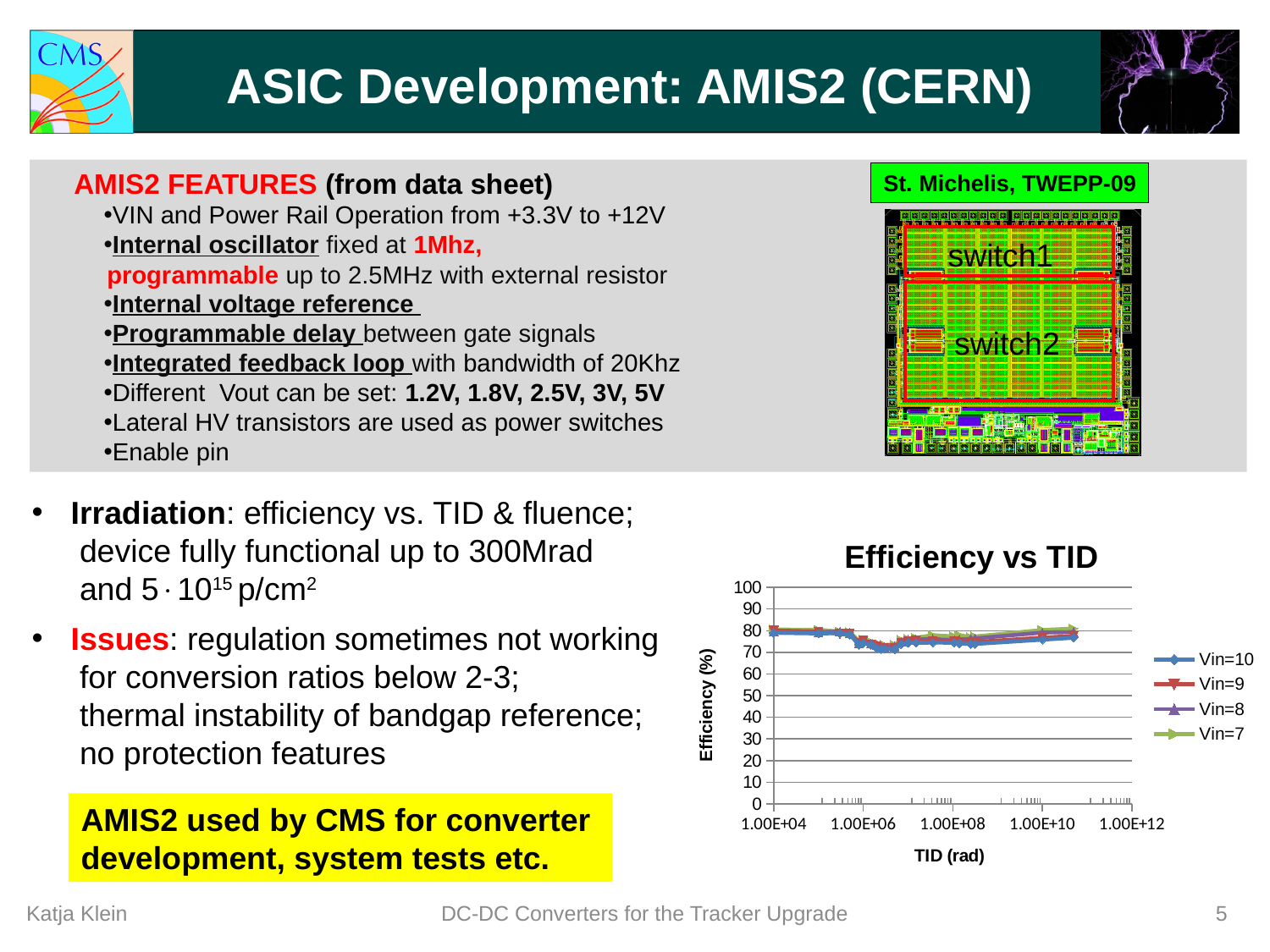
What is the title of the chart on the slide? Efficiency vs TID What is the label of the y axis of the Efficiency vs TID chart? Efficiency (%) In the Efficiency vs TID chart, is the efficiency for Vin=8 at the highest TID greater or less than 40? greater In the Efficiency vs TID chart, is the efficiency for Vin=10 at the lowest TID greater or less than 50? greater What is the maximum value shown on the y axis of the Efficiency vs TID chart? 100 In the Efficiency vs TID chart, is the efficiency for Vin=9 at the lowest TID greater or less than 60? greater What kind of chart is the Efficiency vs TID chart? line chart How many series does the legend of the Efficiency vs TID chart list? 4